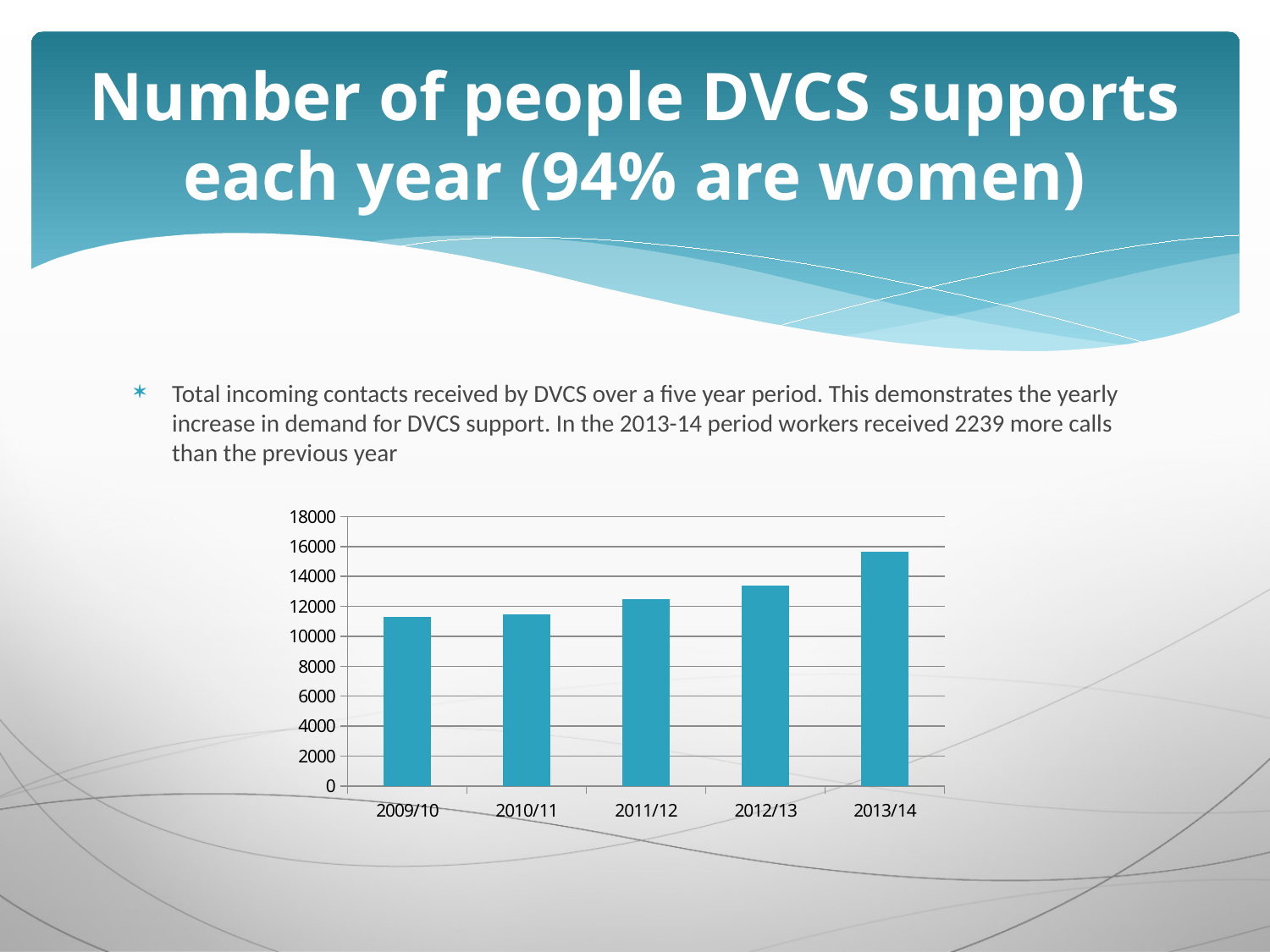
Which is larger, the value for 2009/10 or the value for 2011/12? 2011/12 Is the value for 2011/12 greater or less than 14000? less Which year has the highest bar on the chart? 2013/14 Do the values rise or fall from 2009/10 to 2013/14? rise How many years (categories) are plotted on the chart? 5 Is the value for 2009/10 greater or less than 12000? less Which is larger, the value for 2013/14 or the value for 2012/13? 2013/14 What is the highest value shown on the vertical axis of the chart? 18000 Is the value for 2013/14 greater or less than 14000? greater What kind of chart is shown on the slide? bar chart